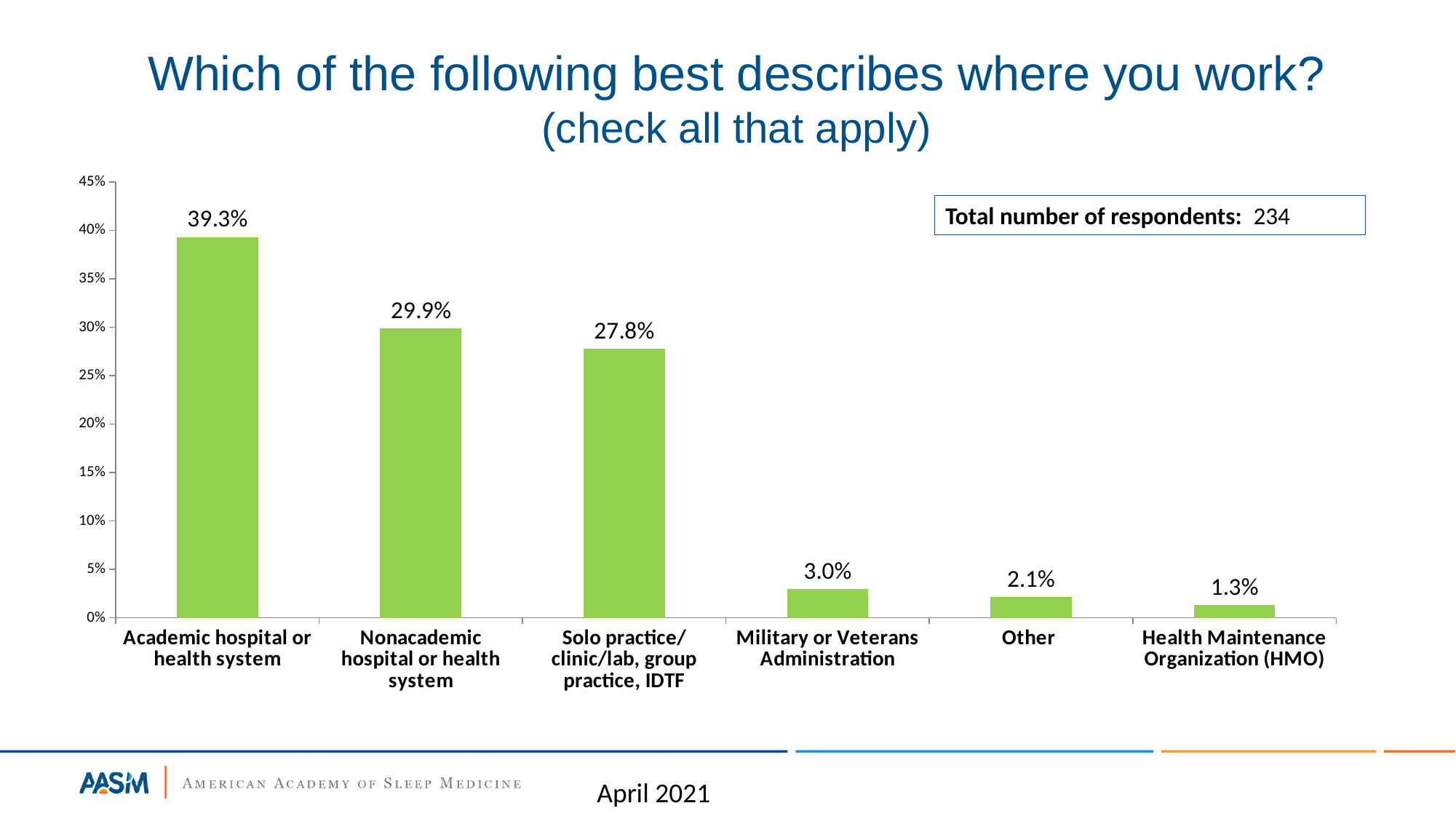
What is the value for Other? 2.1% What percentage of respondents work at an academic hospital or health system? 39.3% What is the value for Health Maintenance Organization (HMO)? 1.3% Which is larger: the value for Nonacademic hospital or health system or the value for Solo practice/clinic/lab, group practice, IDTF? Nonacademic hospital or health system Is the value for Solo practice/clinic/lab, group practice, IDTF greater or less than 30%? less What kind of chart is shown on the slide? bar chart What is the difference between the values for Academic hospital or health system and Nonacademic hospital or health system? 9.4% What is the value for Military or Veterans Administration? 3.0% Which category has the lowest value? Health Maintenance Organization (HMO) What is the total number of respondents shown on the slide? 234 How many categories are shown on the chart? 6 Which category has the highest value? Academic hospital or health system